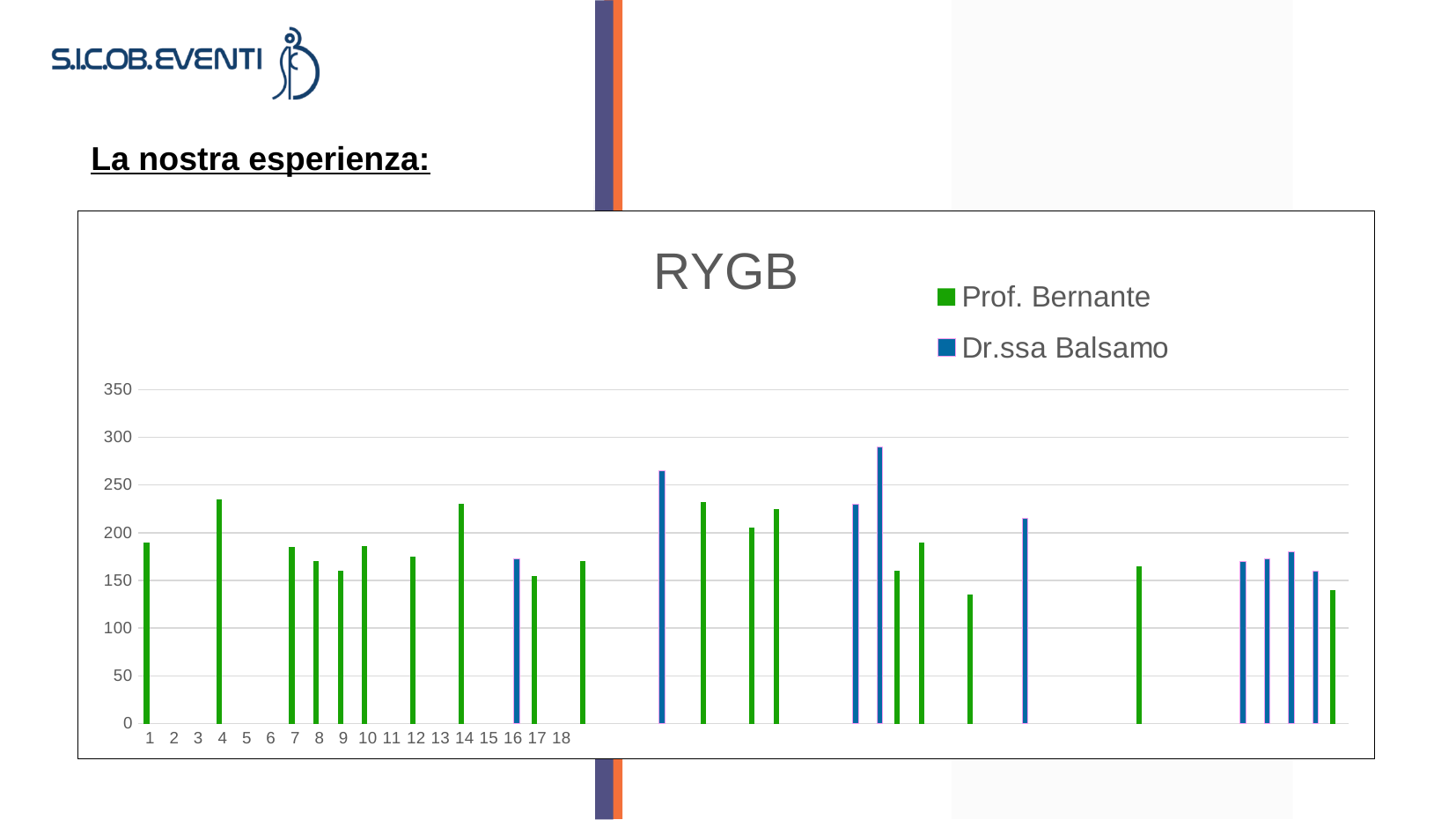
How many series does the legend of the RYGB chart list? 2 Is the value for category 9 greater or less than 200? less Is the value for category 4 greater or less than 200? greater Which has the larger value, category 4 or category 9? category 4 Which has the larger value, category 14 or category 8? category 14 Is the value for category 16 greater or less than 200? less What kind of chart is shown on the slide? bar chart Which series is shown in green in the RYGB chart? Prof. Bernante What is the title of the chart? RYGB